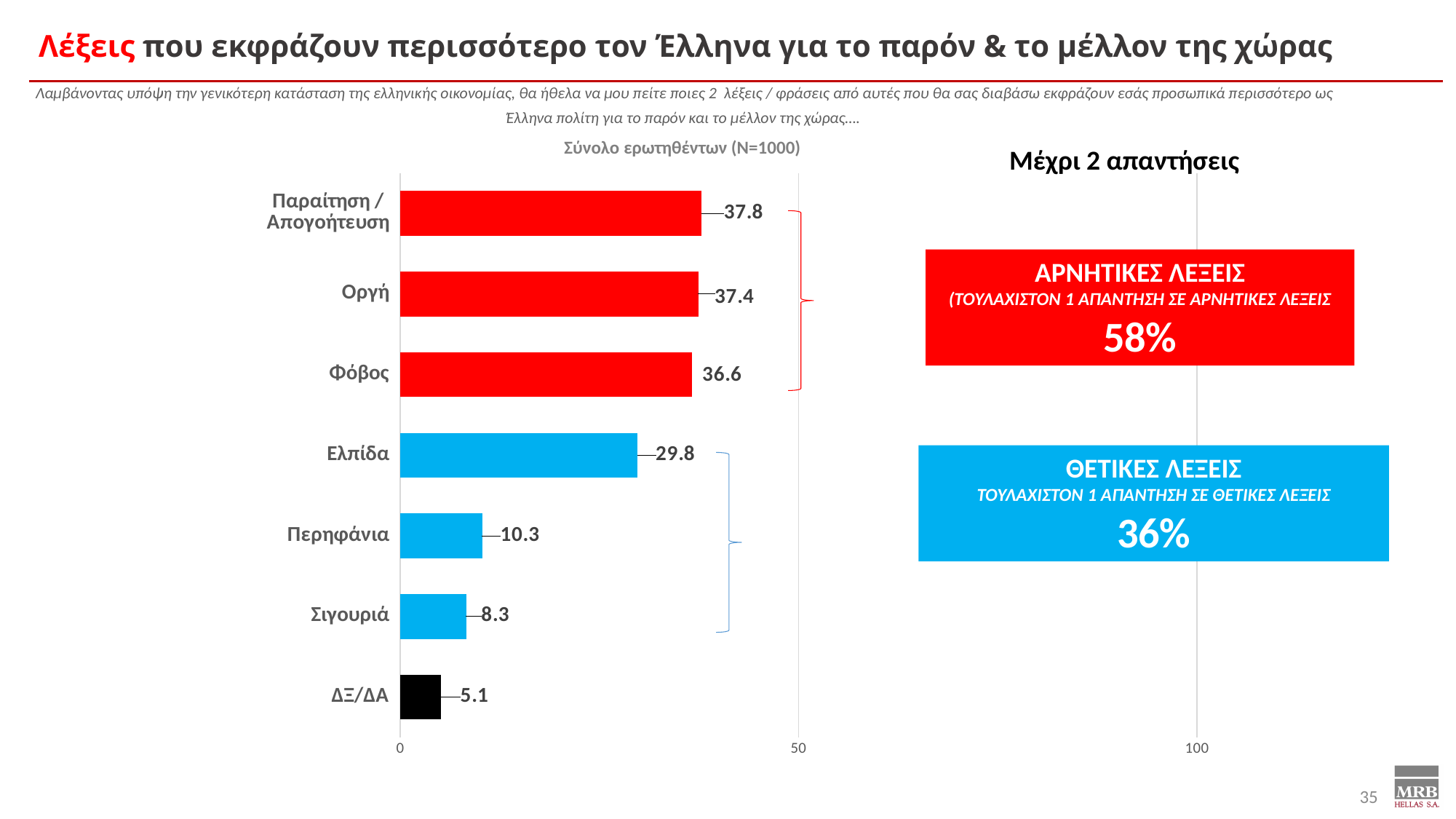
Which is larger, the value for Ελπίδα or the value for Φόβος? Φόβος What is the value for Ελπίδα in the chart? 29.8 What is the value for Φόβος in the chart? 36.6 What is the difference between the values for Οργή and Περηφάνια? 27.1 How many categories are shown in the bar chart? 7 Is the value for Παραίτηση / Απογοήτευση greater or less than 50? less What colour are the bars for Ελπίδα, Περηφάνια and Σιγουριά? blue What is the title of the chart? Σύνολο ερωτηθέντων (N=1000) What kind of chart is shown on the slide? bar chart What is the value for Σιγουριά in the chart? 8.3 Which category has the lowest value in the chart? ΔΞ/ΔΑ Which category has the highest value in the chart? Παραίτηση / Απογοήτευση